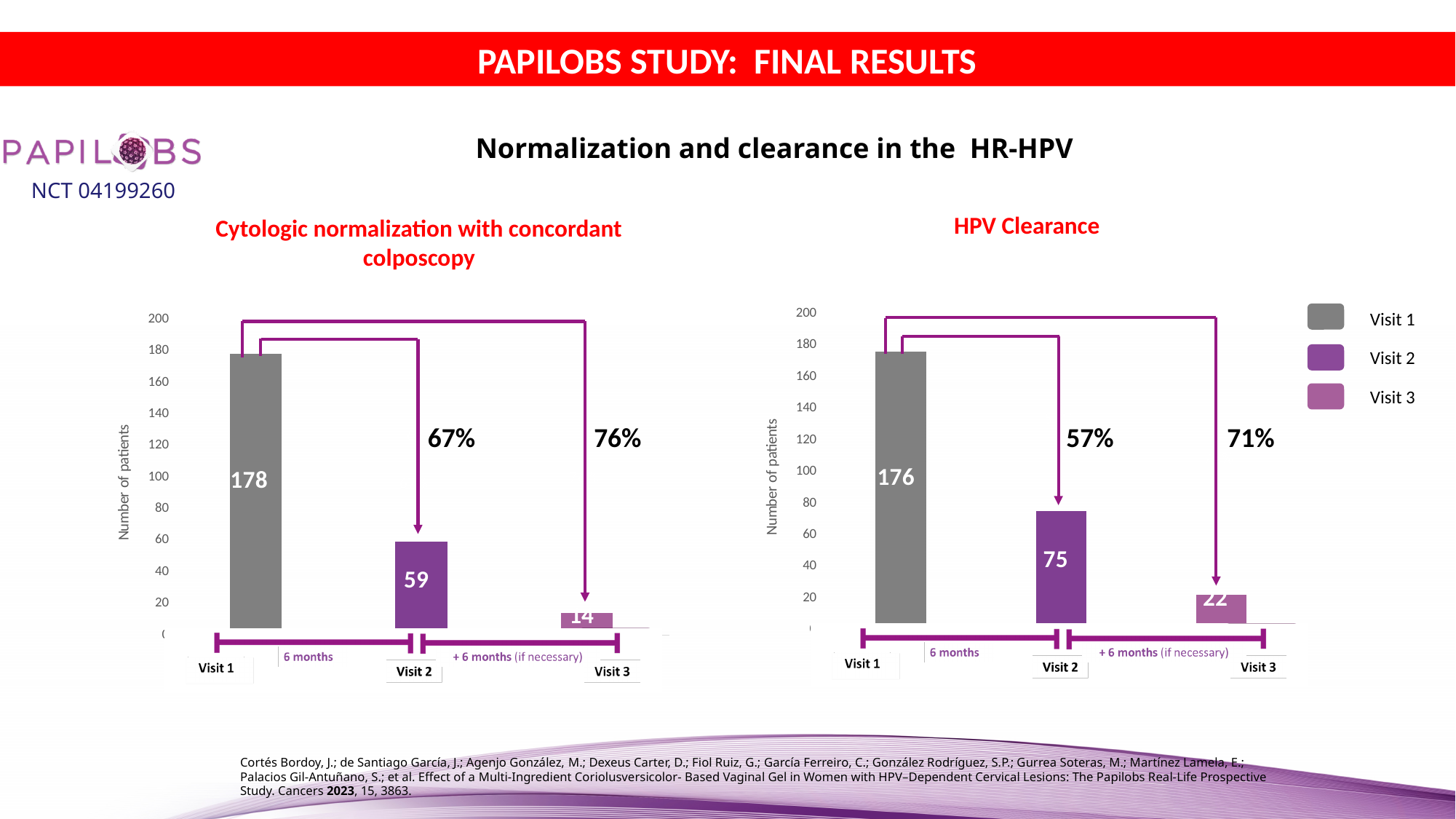
In the 'Cytologic normalization with concordant colposcopy' chart, what is the number of patients at Visit 3? 14 In the 'Cytologic normalization with concordant colposcopy' chart, do the values rise or fall from Visit 1 to Visit 3? fall What kind of chart is the 'HPV Clearance' chart? bar chart How many entries does the legend on the right of the slide list? 3 In the 'HPV Clearance' chart, what is the number of patients at Visit 2? 75 In the 'HPV Clearance' chart, what is the number of patients at Visit 1? 176 In the 'HPV Clearance' chart, which visit has the highest number of patients? Visit 1 In the 'HPV Clearance' chart, what is the difference in number of patients between Visit 1 and Visit 2? 101 In the 'Cytologic normalization with concordant colposcopy' chart, which visit has the lowest number of patients? Visit 3 In the 'Cytologic normalization with concordant colposcopy' chart, what is the number of patients at Visit 1? 178 In the 'HPV Clearance' chart, what is the number of patients at Visit 3? 22 In the 'Cytologic normalization with concordant colposcopy' chart, what is the number of patients at Visit 2? 59